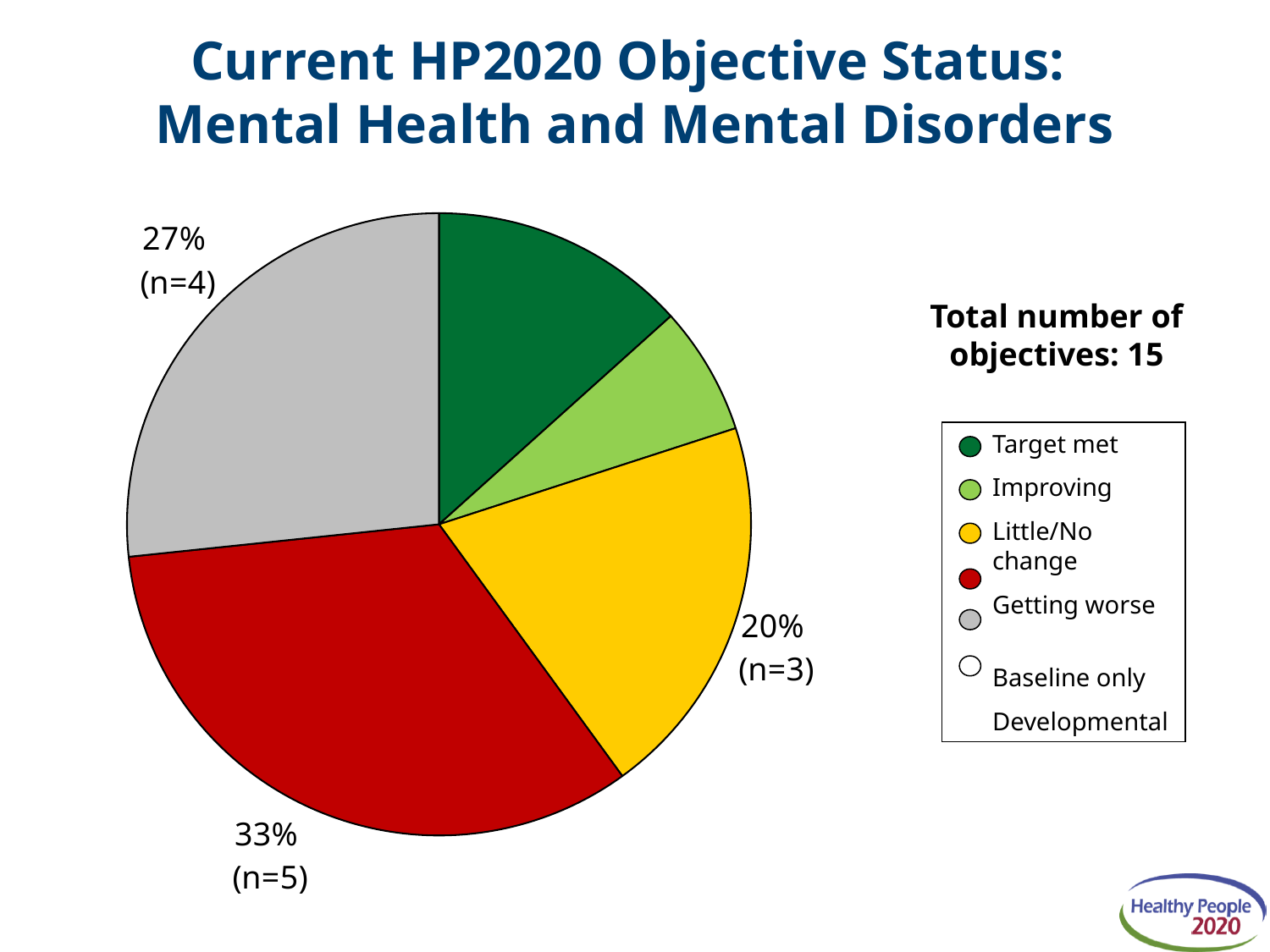
What colour represents the "Getting worse" category? red How many more objectives are in "Getting worse" than in "Little/No change"? 2 What is the total number of objectives stated on the slide? 15 Which slice is larger: "Baseline only" or "Little/No change"? Baseline only What percentage of objectives are in the "Little/No change" category? 20% What kind of chart is shown on the slide? pie chart What percentage of objectives are in the "Getting worse" category? 33% How many objectives (n) are in the "Getting worse" category? 5 Which category has the smallest slice of the pie? Improving Which category has the largest slice of the pie? Getting worse How many entries does the legend list? 6 What percentage of objectives are in the "Baseline only" category? 27%